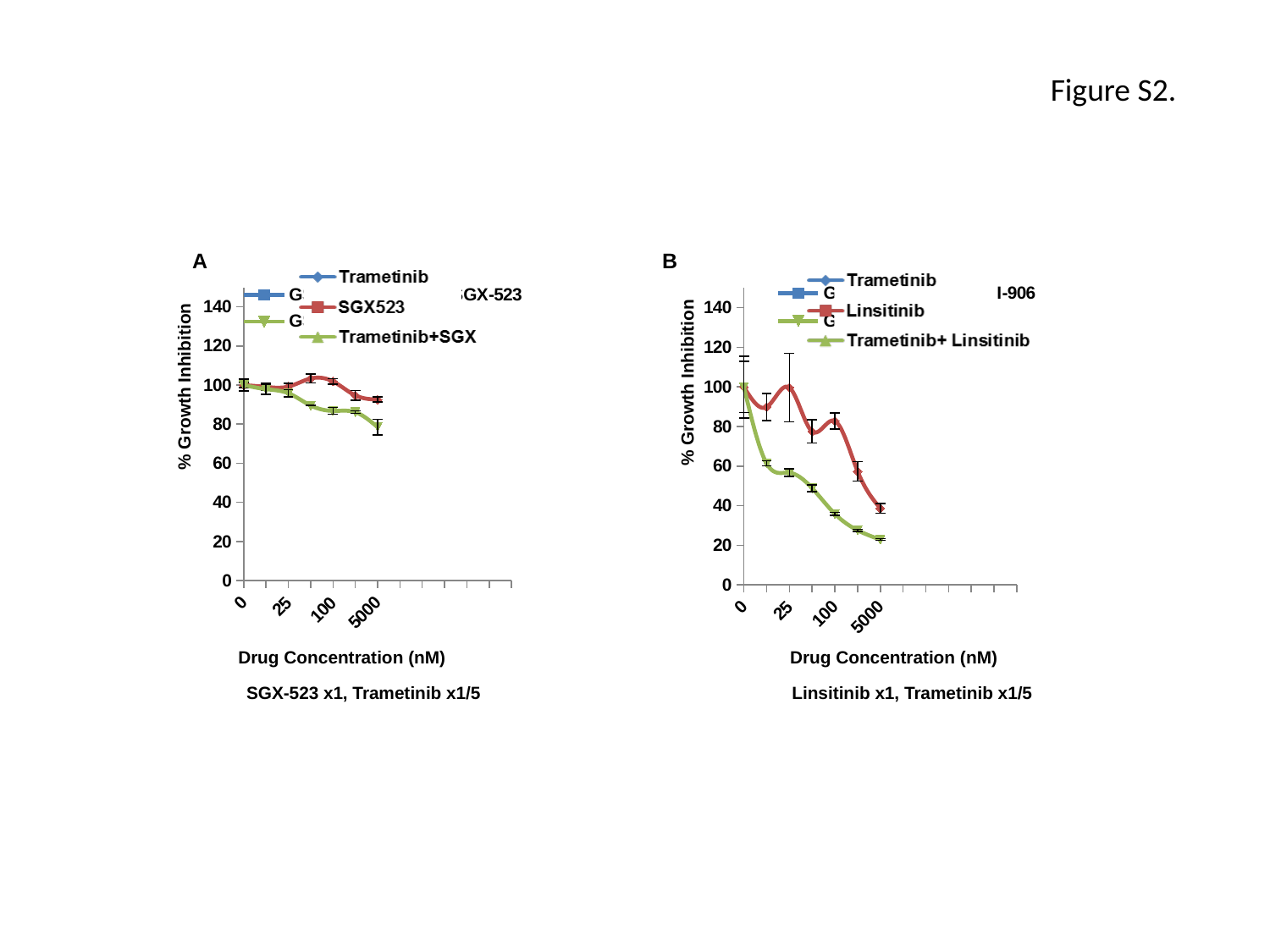
In chart A (SGX-523), is the value for Trametinib+SGX at 5000 nM greater or less than 100? less What kind of chart is chart A (SGX-523)? line chart In chart B (I-906), is the value for Linsitinib at 5000 nM greater or less than 60? less In chart B (I-906), is the value for Trametinib+ Linsitinib at 5000 nM greater or less than 40? less What is the x-axis title of chart B (I-906)? Drug Concentration (nM) In chart B (I-906), which series has the higher value at 5000 nM, Linsitinib or Trametinib+ Linsitinib? Linsitinib In chart B (I-906), does the Trametinib+ Linsitinib series rise or fall as drug concentration increases? fall What is the y-axis title of chart A (SGX-523)? % Growth Inhibition In chart A (SGX-523), which series has the higher value at 5000 nM, SGX523 or Trametinib+SGX? SGX523 How many series does the legend of chart B (I-906) list? 3